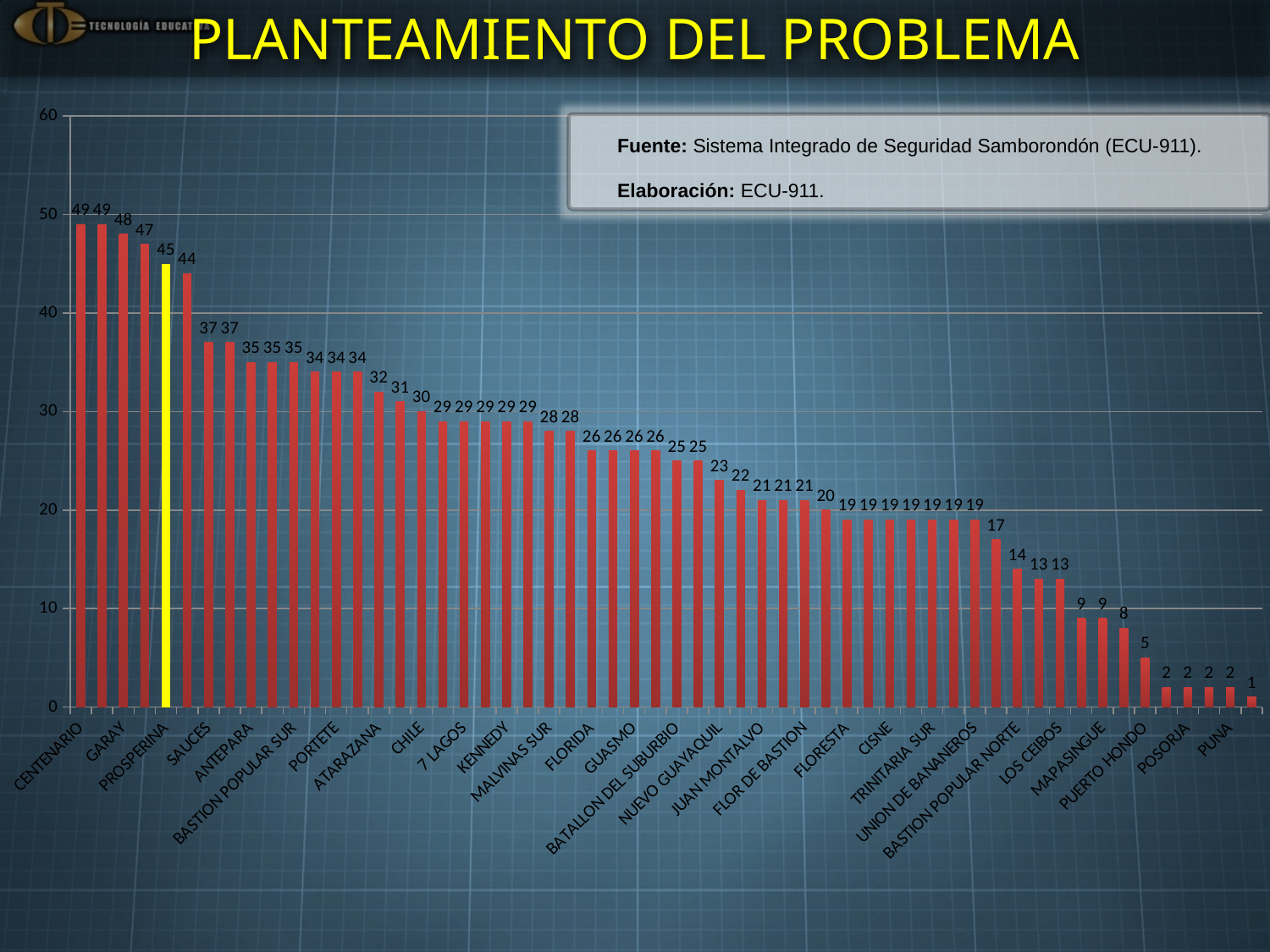
What kind of chart is shown on the slide? bar chart What is the value for FLORIDA? 26 What is the value for CENTENARIO? 49 What is the value for SAUCES? 37 What is the value for FLORESTA? 19 What is the difference between the values for CENTENARIO and PROSPERINA? 4 Is the value for PUNA greater or less than 10? less Which has a larger value, CENTENARIO or PROSPERINA? CENTENARIO Which category's bar is highlighted in yellow? PROSPERINA What is the value for PROSPERINA? 45 What is the value for KENNEDY? 29 Do the values rise or fall from left to right along the x axis? fall